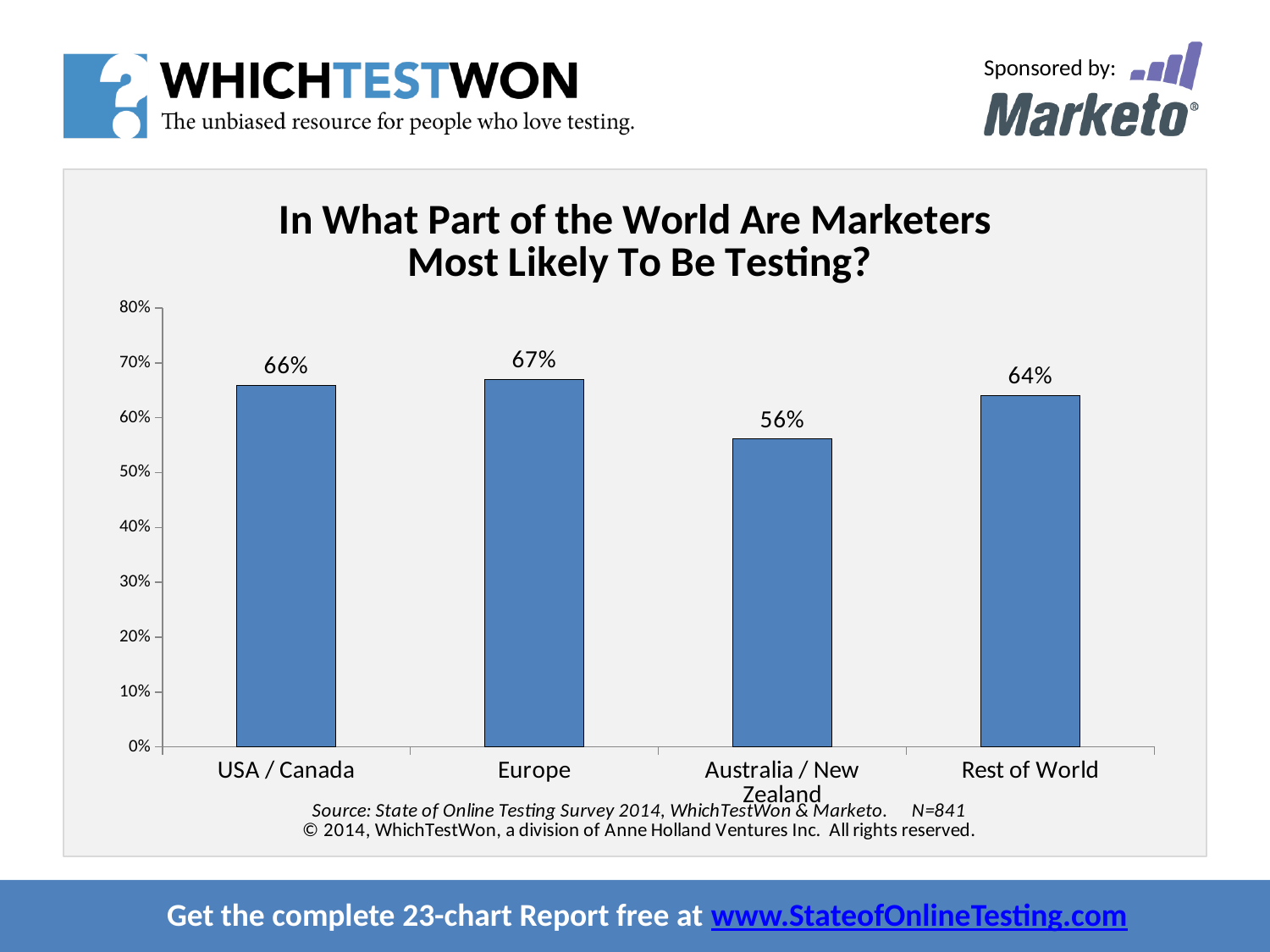
What is the difference between the values for USA / Canada and Rest of World? 2% Is the value for Australia / New Zealand greater or less than 60%? less What is the value for USA / Canada? 66% What is the difference between the values for Europe and Australia / New Zealand? 11% What is the title of the chart? In What Part of the World Are Marketers Most Likely To Be Testing? Which is larger, the value for Rest of World or the value for Australia / New Zealand? Rest of World What is the value for Europe? 67% Which region has the lowest value? Australia / New Zealand What is the value for Rest of World? 64% What kind of chart is shown on the slide? bar chart What is the value for Australia / New Zealand? 56% How many regions are shown on the chart? 4